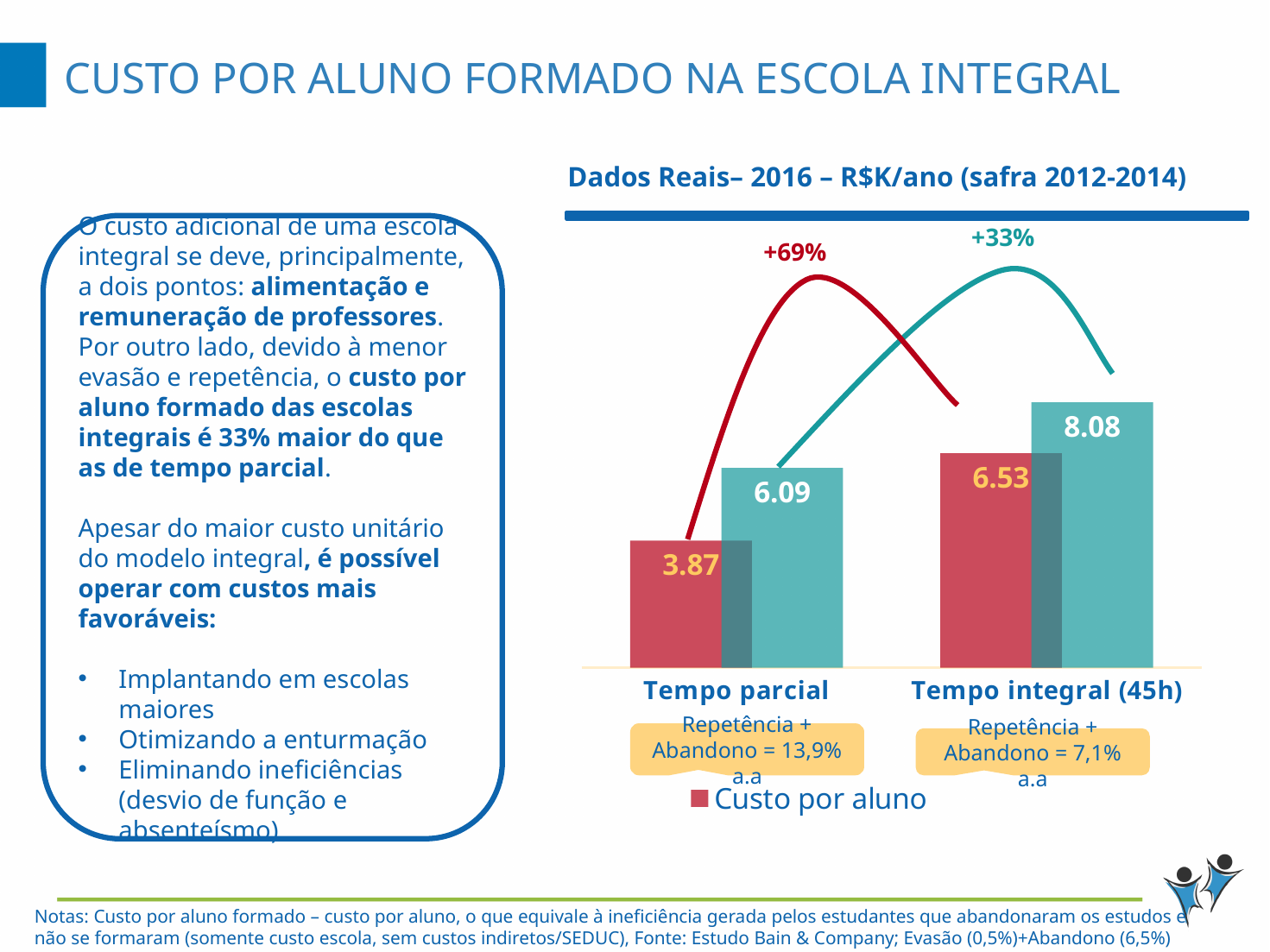
What is the difference between the teal bar values for Tempo integral (45h) and Tempo parcial? 1.99 Do the Custo por aluno values rise or fall from Tempo parcial to Tempo integral (45h)? Rise What is the difference in Custo por aluno between Tempo integral (45h) and Tempo parcial? 2.66 Which bar shows the highest value in the chart? The teal bar for Tempo integral (45h), 8.08 What value is shown on the teal bar for Tempo parcial? 6.09 How many categories are shown on the x axis of the chart? 2 What percentage is written above the red arrow in the chart? +69% What is the Custo por aluno value for Tempo integral (45h)? 6.53 Which category has the higher Custo por aluno, Tempo parcial or Tempo integral (45h)? Tempo integral (45h) What value is shown on the teal bar for Tempo integral (45h)? 8.08 What is the Custo por aluno value for Tempo parcial? 3.87 What kind of chart is shown on the slide? Bar chart